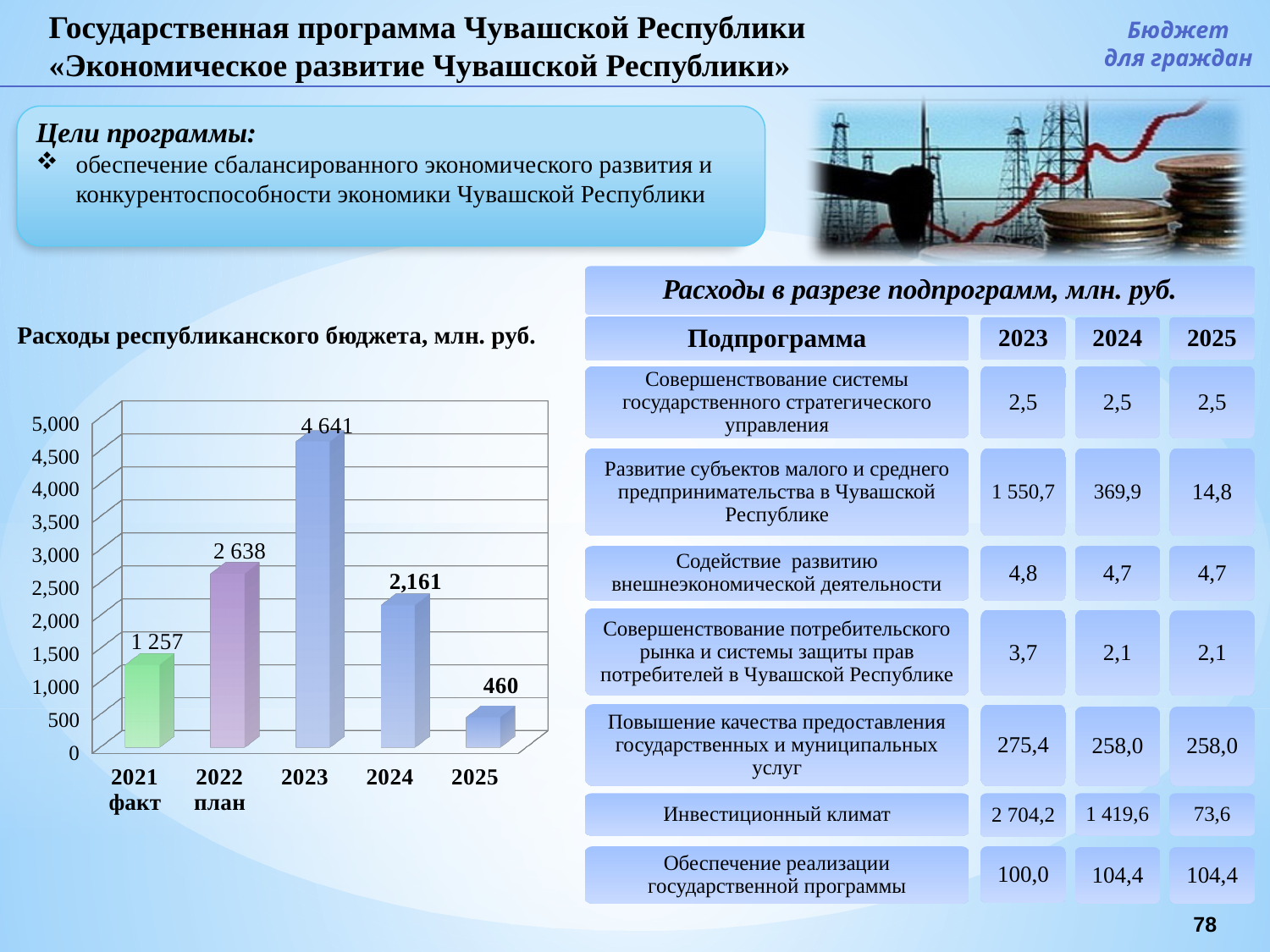
What is the title of the chart on the slide? Расходы республиканского бюджета, млн. руб. How many categories (years) are shown on the chart? 5 What is the value for 2023 on the chart? 4 641 What type of chart is shown on the slide? bar chart What is the value for 2025 on the chart? 460 Which is larger, the value for 2022 план or the value for 2024? 2022 план What is the difference between the values for 2023 and 2022 план? 2 003 Which year has the lowest value on the chart? 2025 Do the values rise or fall from 2023 to 2025 on the chart? fall What is the value for 2022 план on the chart? 2 638 Which year has the highest value on the chart? 2023 What is the value for 2021 факт on the chart? 1 257